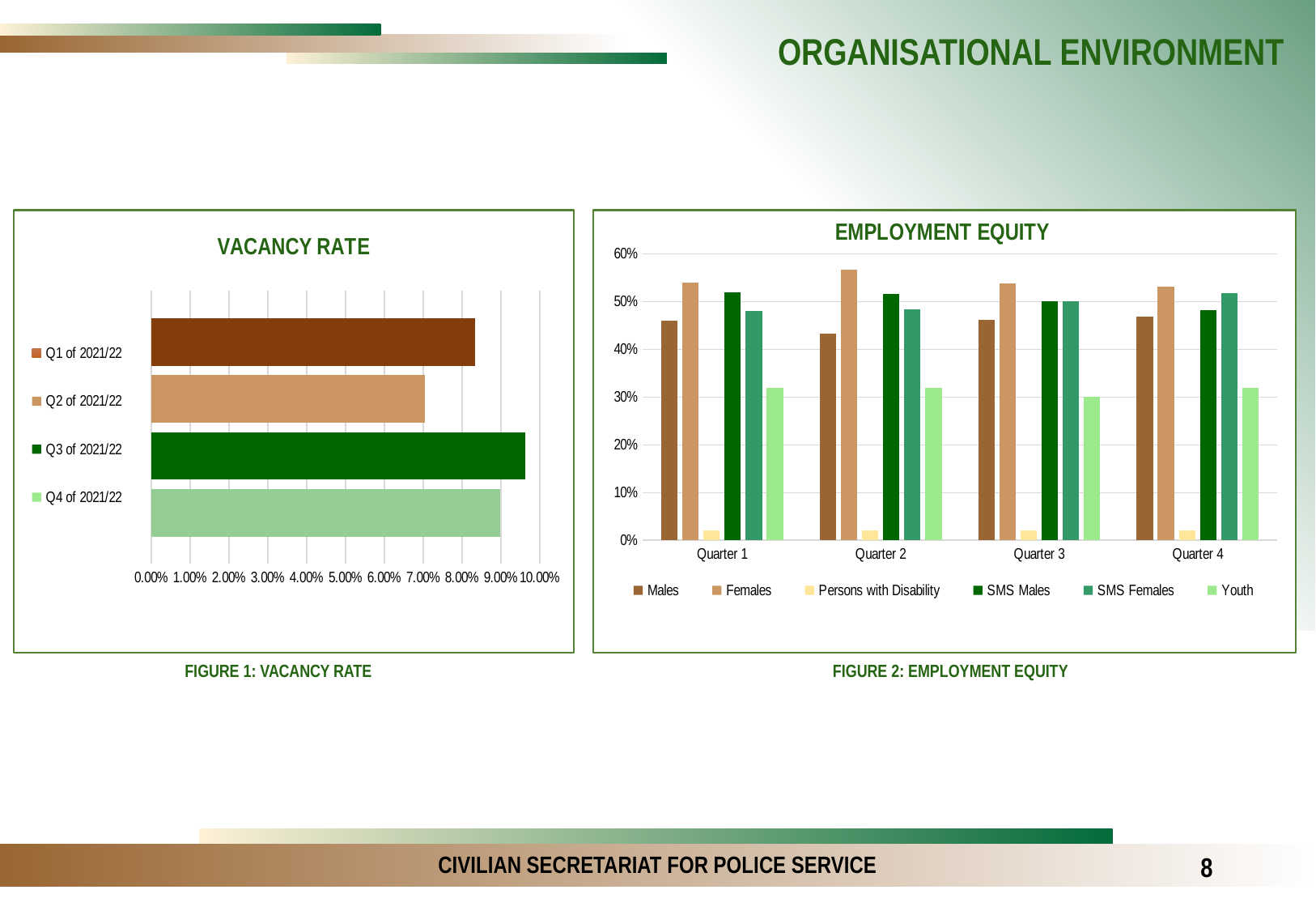
In the Vacancy Rate chart, which quarter has the lowest vacancy rate? Q2 of 2021/22 What kind of chart is the Vacancy Rate chart? bar chart In the Vacancy Rate chart, which quarter has the highest vacancy rate? Q3 of 2021/22 In the Employment Equity chart, is the value for Males in Quarter 2 greater or less than 50%? less How many quarters are shown in the Vacancy Rate chart? 4 In the Employment Equity chart, is the value for Females in Quarter 2 greater or less than 50%? greater In the Employment Equity chart, which series has the highest value in Quarter 2? Females In the Vacancy Rate chart, is the value for Q3 of 2021/22 greater or less than 9.00%? greater In the Employment Equity chart, which series has the lowest value in Quarter 1? Persons with Disability How many series does the legend of the Employment Equity chart list? 6 In the Vacancy Rate chart, which is larger, the value for Q1 of 2021/22 or Q2 of 2021/22? Q1 of 2021/22